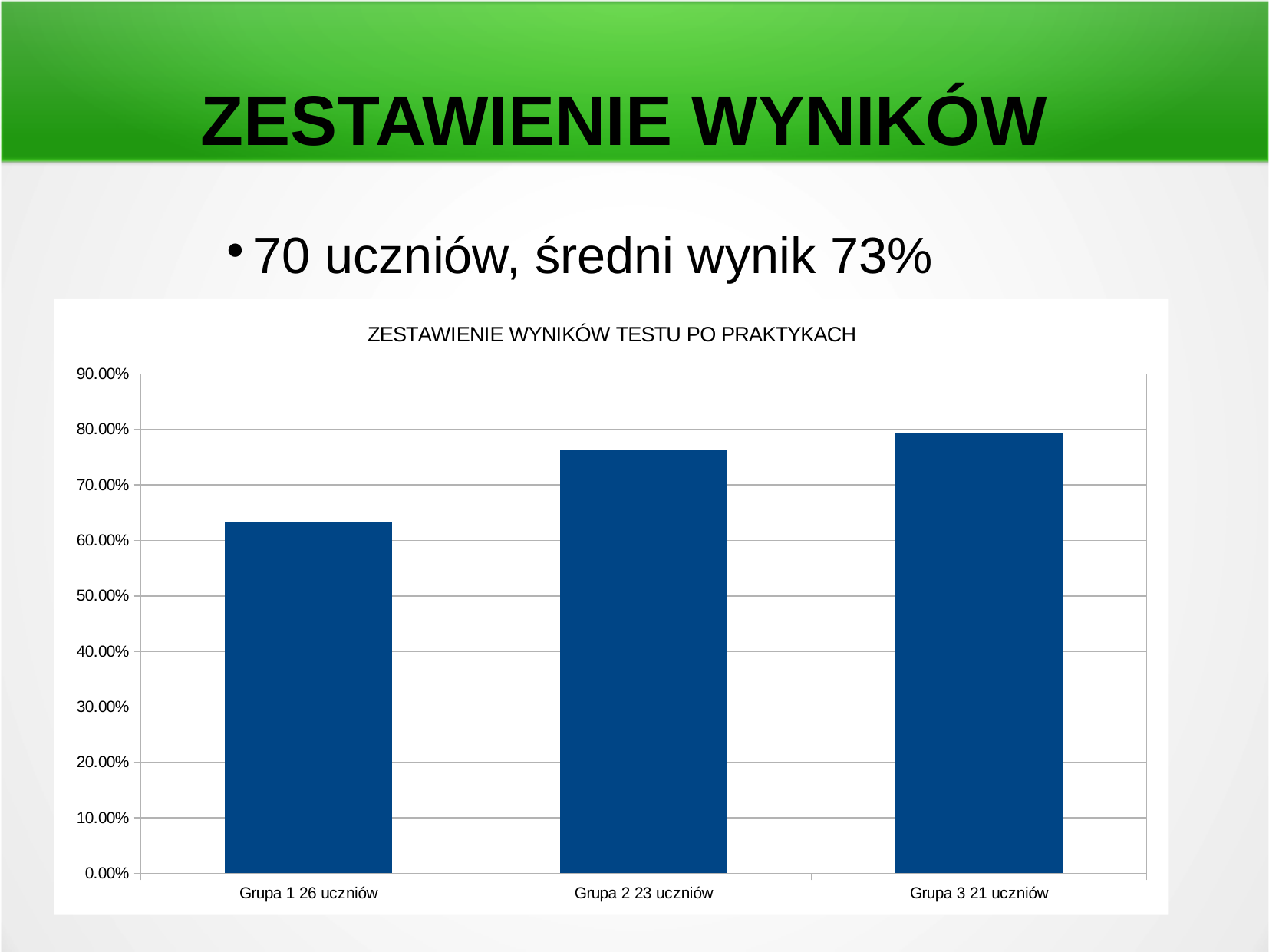
Which group has the lowest test result? Grupa 1 26 uczniów Is the value for Grupa 1 26 uczniów greater or less than 70.00%? less What kind of chart is shown on the slide? bar chart Is the value for Grupa 1 26 uczniów greater or less than 60.00%? greater Is the value for Grupa 2 23 uczniów greater or less than 70.00%? greater Which has a higher test result, Grupa 1 26 uczniów or Grupa 2 23 uczniów? Grupa 2 23 uczniów How many groups (bars) are shown in the chart? 3 What is the title of the chart? ZESTAWIENIE WYNIKÓW TESTU PO PRAKTYKACH Which group has the highest test result? Grupa 3 21 uczniów Do the values rise or fall from Grupa 1 to Grupa 3 along the x axis? rise